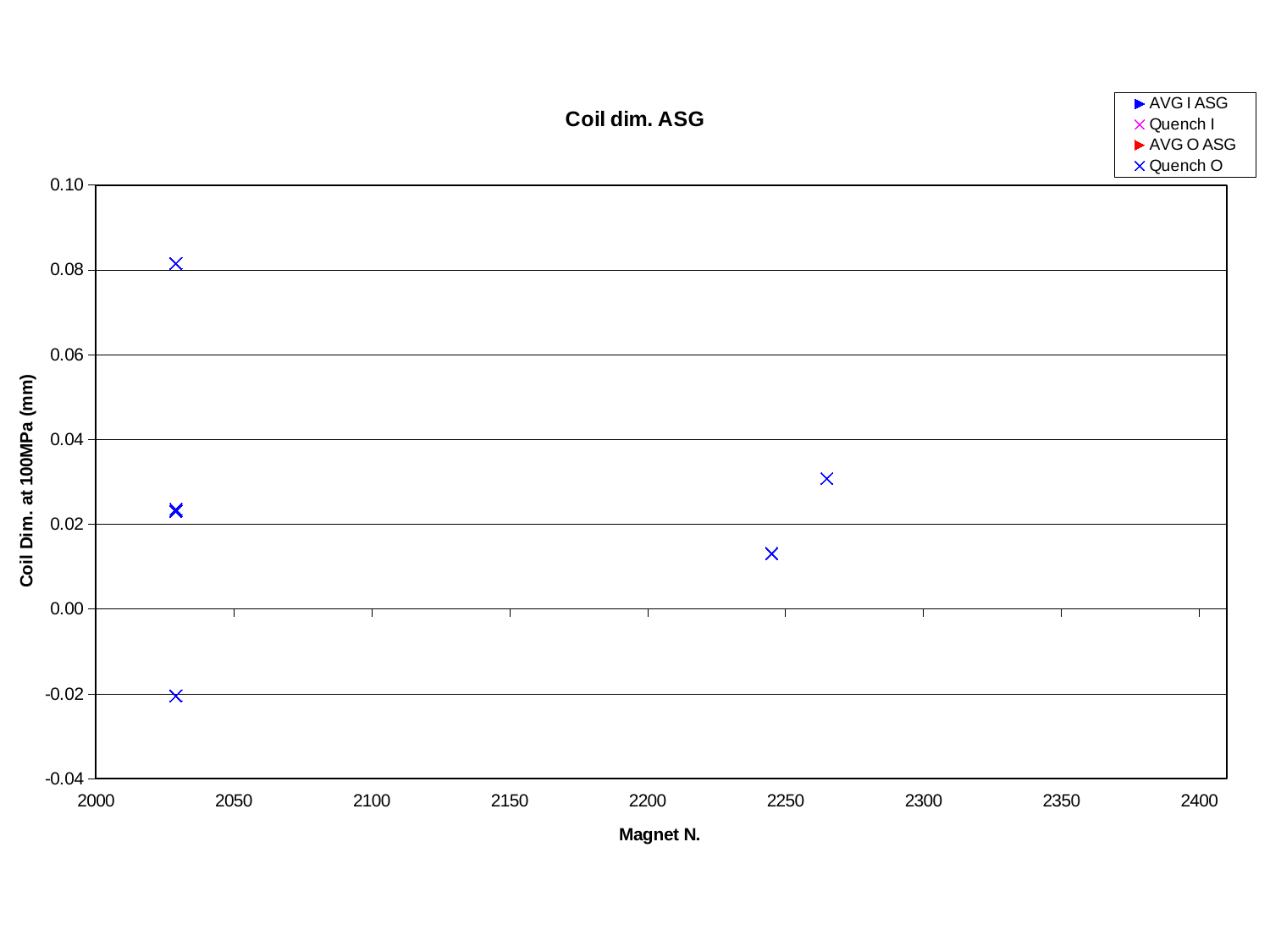
Is the value of the point plotted near magnet number 2245 greater or less than 0.02? less Is the highest plotted point on the chart greater or less than 0.06? greater What is the title of the chart? Coil dim. ASG How many series does the legend list? 4 What is the lowest value shown on the x axis? 2000 Is the lowest plotted point on the chart greater or less than 0.00? less What is the highest value shown on the y axis? 0.10 What kind of chart is shown on the slide? scatter chart Which is larger: the value of the point near magnet number 2265 or the value of the point near magnet number 2245? the point near 2265